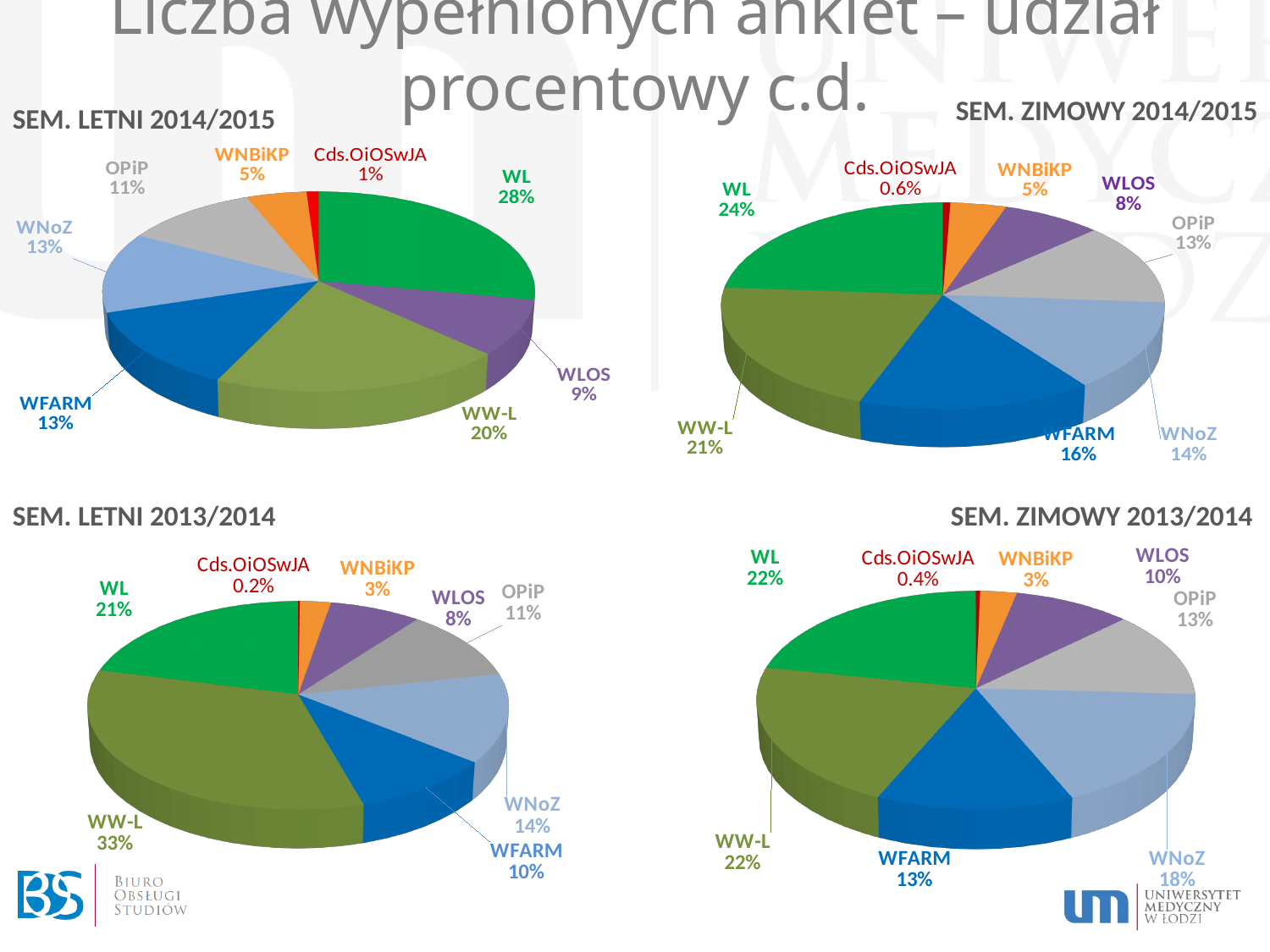
In the SEM. ZIMOWY 2014/2015 chart, what share does WFARM have? 16% How many pie charts are shown on the slide? 4 In the SEM. ZIMOWY 2013/2014 chart, what share does WLOS have? 10% In the SEM. LETNI 2014/2015 chart, what share does WL have? 28% In the SEM. ZIMOWY 2013/2014 chart, which category has the smallest share? Cds.OiOSwJA In the SEM. LETNI 2014/2015 chart, what is the difference between the shares of WL and WW-L? 8% In the SEM. ZIMOWY 2014/2015 chart, what is the difference between the shares of WW-L and WLOS? 13% In the SEM. ZIMOWY 2013/2014 chart, which is larger, the share of WNoZ or the share of OPiP? WNoZ In the SEM. LETNI 2013/2014 chart, which category has the largest share? WW-L How many categories are shown in the SEM. LETNI 2013/2014 chart? 8 What kind of chart is used for SEM. ZIMOWY 2014/2015? Pie chart In the SEM. LETNI 2013/2014 chart, what share does Cds.OiOSwJA have? 0.2%